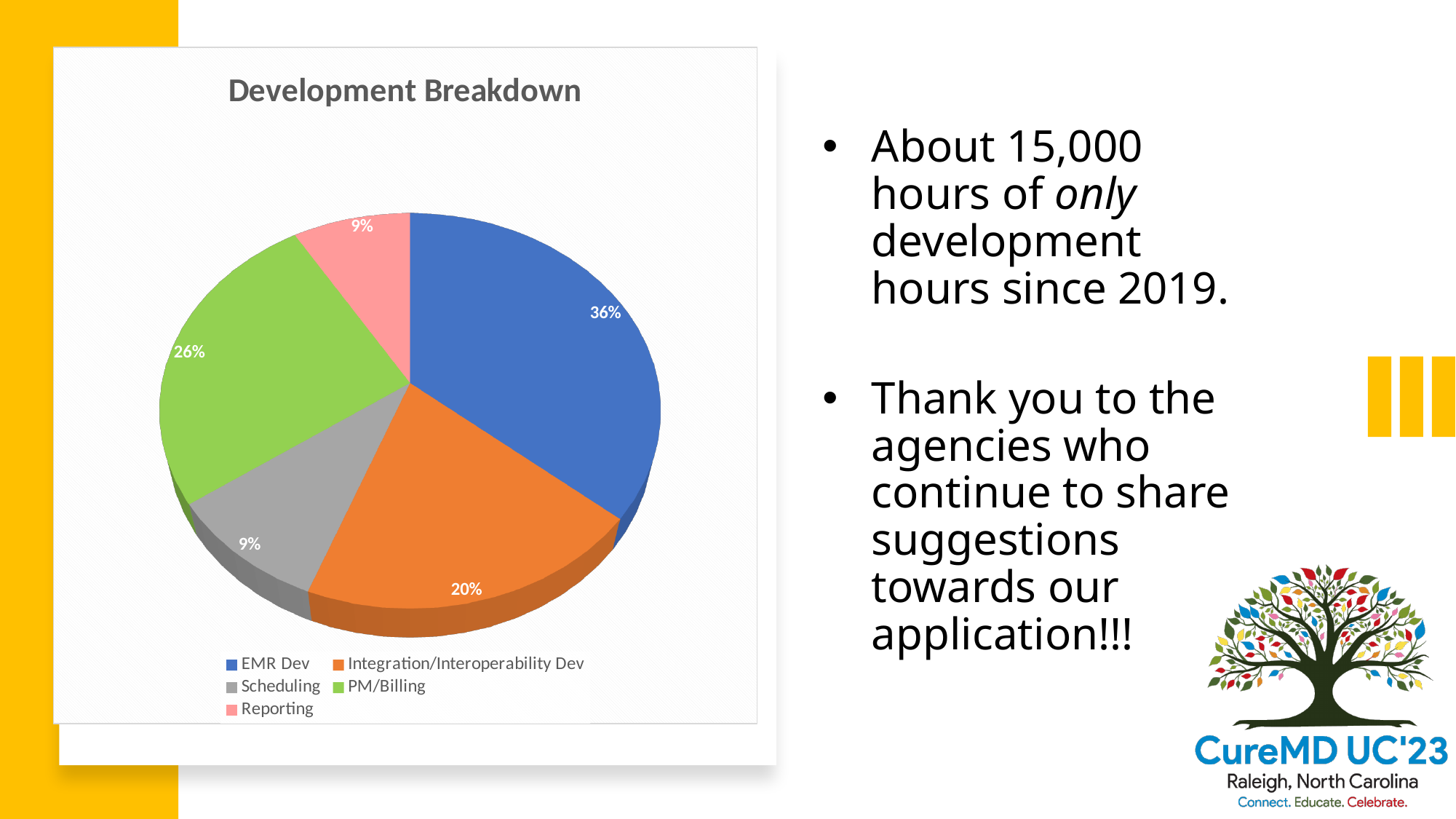
What share of the pie does EMR Dev represent? 36% What is the title of the chart? Development Breakdown How many categories does the legend list? 5 What kind of chart is shown on the slide? pie chart What share of the pie does Reporting represent? 9% What is the difference in percentage points between EMR Dev and PM/Billing? 10 Which is larger, the share for Integration/Interoperability Dev or the share for PM/Billing? PM/Billing What share of the pie does Integration/Interoperability Dev represent? 20% Which colour represents PM/Billing in the chart? green What share of the pie does PM/Billing represent? 26% What share of the pie does Scheduling represent? 9% Which category has the largest share of the pie? EMR Dev